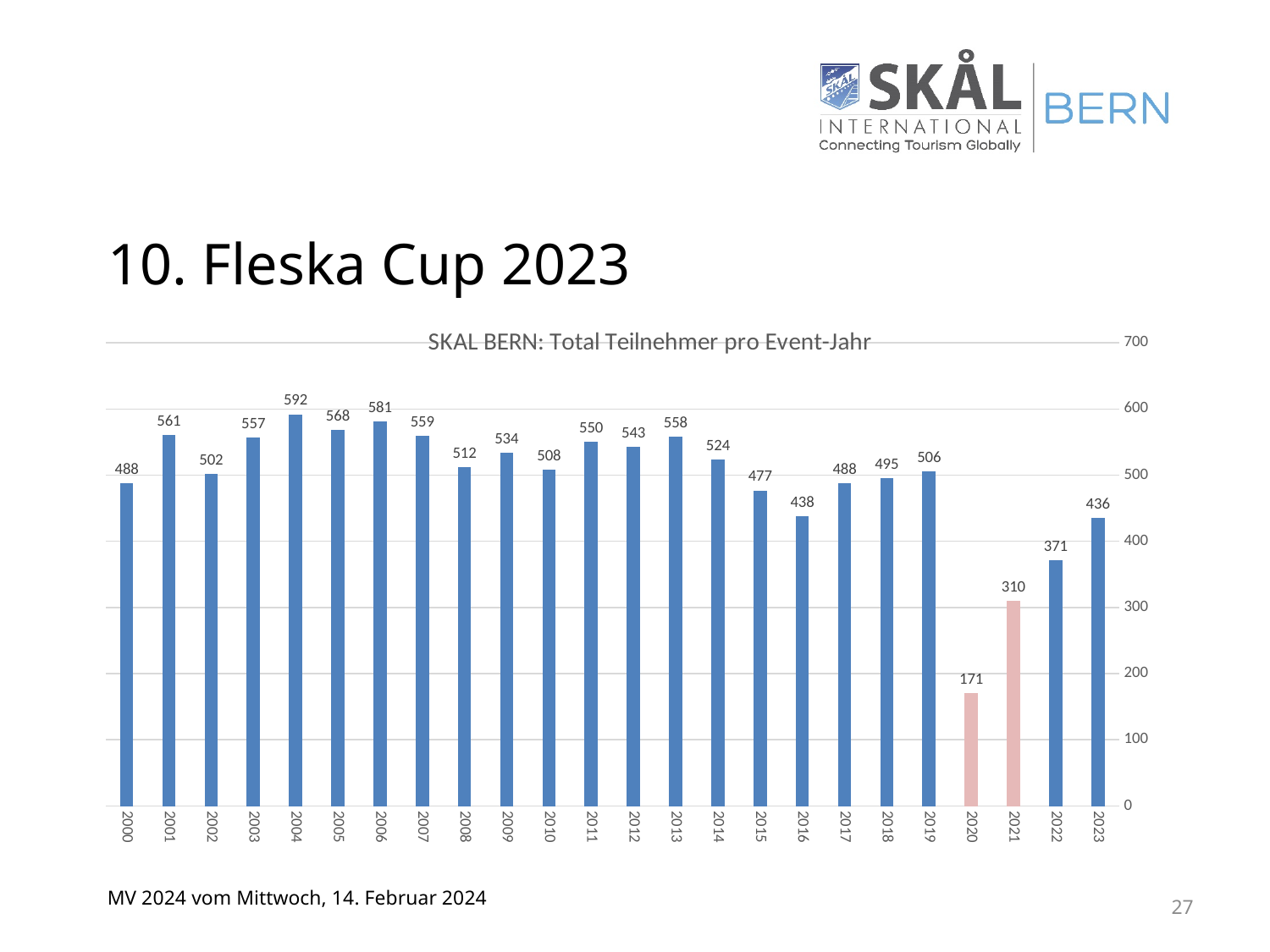
Which is larger, the value for 2006 or the value for 2013? 2006 What is the title of the chart? SKAL BERN: Total Teilnehmer pro Event-Jahr How many years are shown on the x axis? 24 Which year has the lowest value? 2020 What is the value for 2020? 171 What is the difference between the values for 2019 and 2020? 335 Is the value for 2021 greater or less than 400? less Which year has the highest value? 2004 What is the value for 2023? 436 What kind of chart is shown? bar chart Do the values rise or fall from 2019 to 2020? fall What is the value for 2004? 592